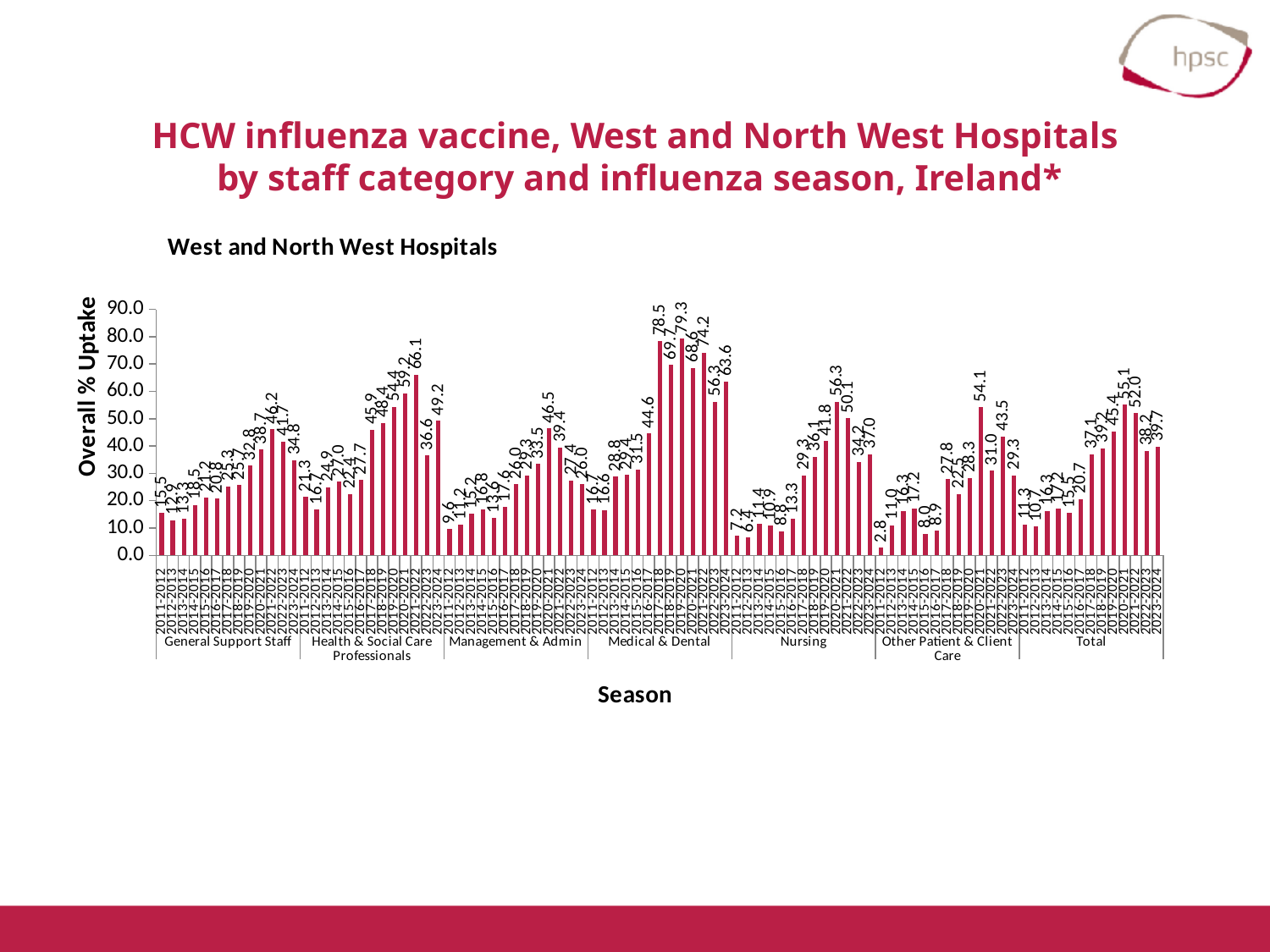
Is the value for Medical & Dental in 2017-2018 greater or less than 70.0? greater What is the difference between the Total category's 2020-2021 value (55.1) and its 2023-2024 value (39.7)? 15.4 What type of chart is shown on the slide? Bar chart In the 2023-2024 season, which is larger: the value for Medical & Dental or the value for Nursing? Medical & Dental Which staff category has the highest overall % uptake value in any season, and what is that value? Medical & Dental, 79.3 What is the overall % uptake for Medical & Dental in the 2023-2024 season? 63.6 What is the highest overall % uptake value shown for Management & Admin? 46.5 What is the lowest overall % uptake value shown for Other Patient & Client Care? 2.8 How many staff categories are shown along the x axis? 7 What is the overall % uptake for the Total category in the 2023-2024 season? 39.7 What is the highest overall % uptake value shown for Health & Social Care Professionals? 66.1 What is the title of the y axis? Overall % Uptake